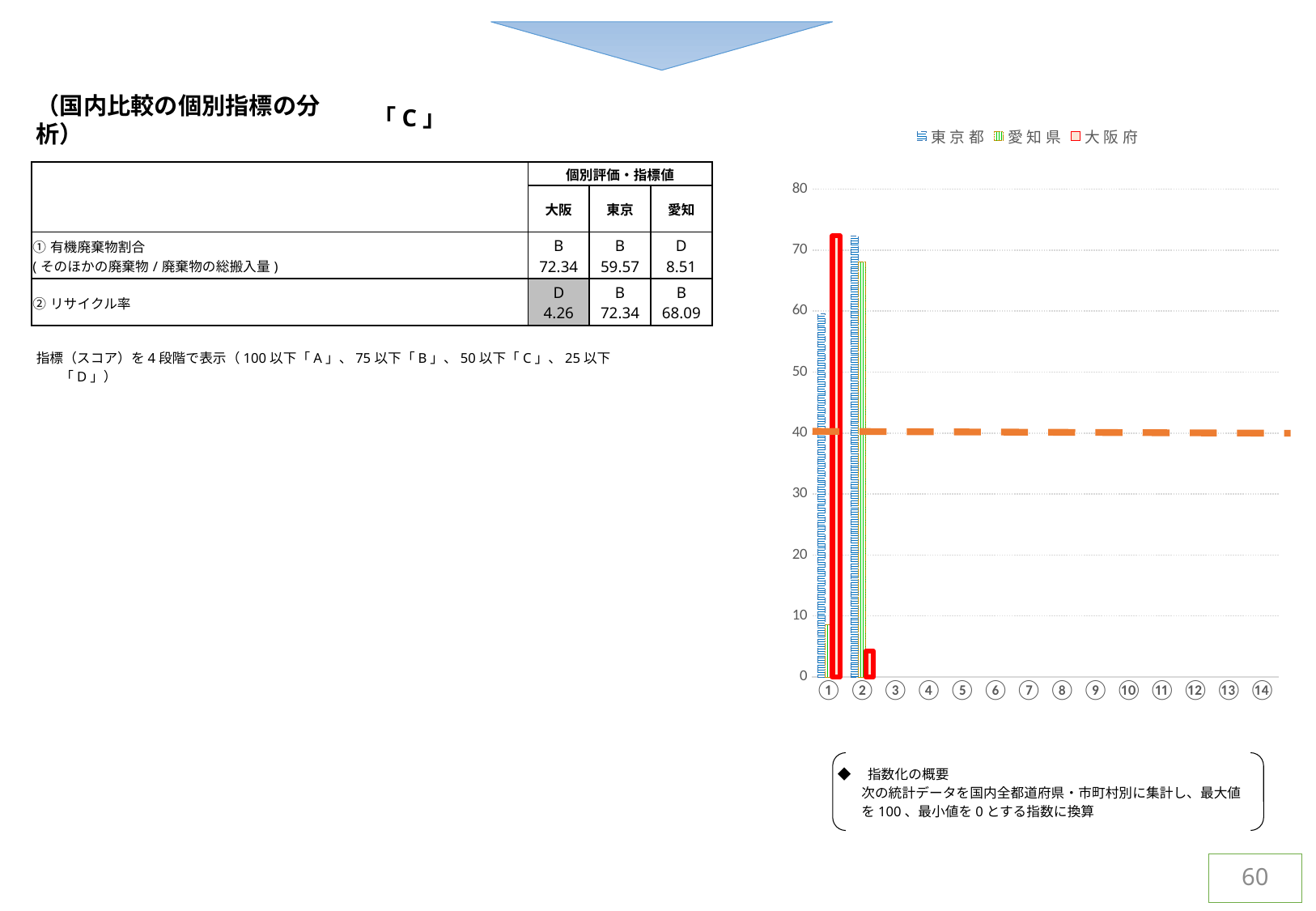
How many series does the legend of the chart list? 3 How many categories are shown along the x axis of the chart? 14 Is the value for 東京都 at category ① greater or less than 50? greater At what value on the y axis is the dashed horizontal line drawn across the chart? 40 At category ②, which series has the larger value, 東京都 or 大阪府? 東京都 Is the value for 大阪府 at category ② greater or less than 10? less Which series has the lowest value at category ②? 大阪府 What kind of chart is shown on the right side of the slide? bar chart Is the value for 大阪府 at category ① greater or less than 60? greater At category ①, which series has the larger value, 大阪府 or 東京都? 大阪府 Which series has the lowest value at category ①? 愛知県